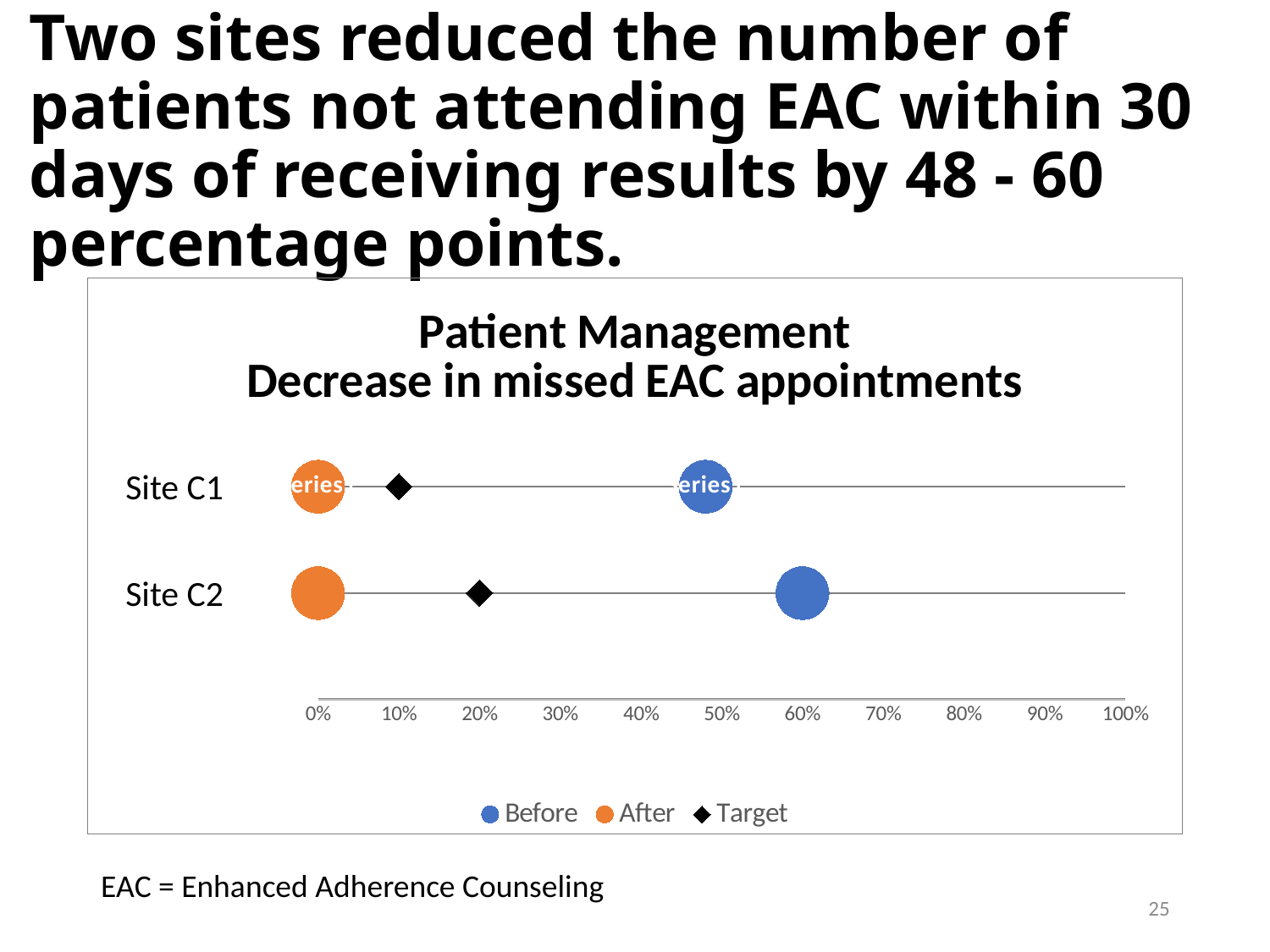
How many sites are plotted on the chart? 2 What is the Target value for Site C1? 10% What is the title of the chart? Patient Management Decrease in missed EAC appointments What is the Target value for Site C2? 20% How many series does the legend list? 3 What is the difference between the Before and After values for Site C2? 60% Which site has the higher Target value? Site C2 What is the After value for Site C2? 0% Which site has the higher Before value? Site C2 What kind of chart is shown on the slide? Scatter (dot) chart What is the Before value for Site C2? 60% Is the Before value for Site C1 greater or less than 40%? greater